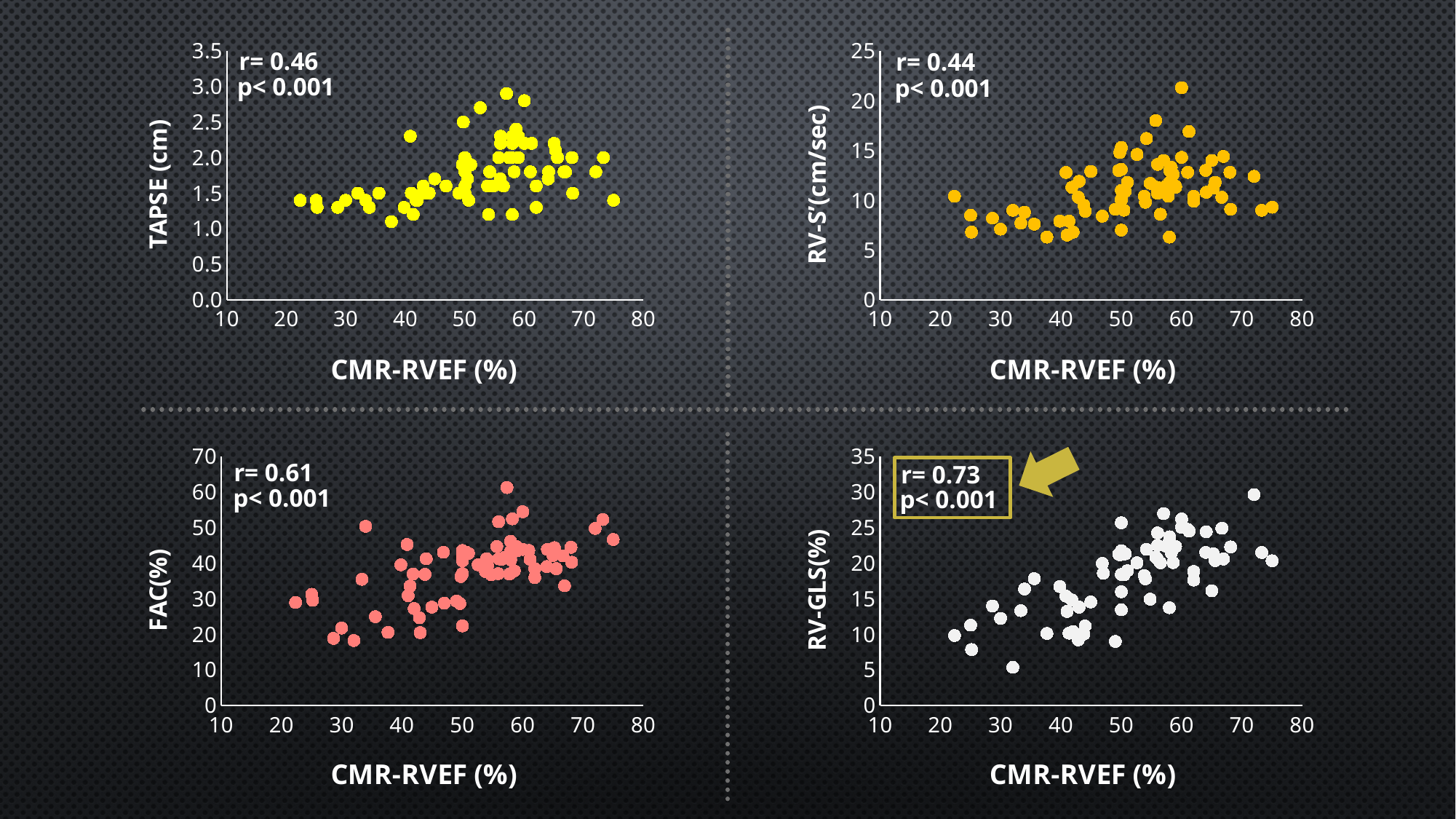
What p value is shown on the bottom-right chart (RV-GLS vs CMR-RVEF)? p< 0.001 What is the difference between the r value of the RV-GLS chart and the r value of the FAC chart? 0.12 Which of the four charts shows the highest correlation coefficient r? RV-GLS vs CMR-RVEF (r= 0.73) In the top-left chart (TAPSE vs CMR-RVEF), is the highest TAPSE value greater or less than 2.5? greater What is the x-axis label shared by all four charts? CMR-RVEF (%) How many scatter charts are shown on the slide? 4 What is the correlation coefficient r shown on the top-left chart (TAPSE vs CMR-RVEF)? r= 0.46 In the bottom-right chart (RV-GLS vs CMR-RVEF), do the RV-GLS values generally rise or fall as CMR-RVEF increases? rise What is the correlation coefficient r shown on the bottom-left chart (FAC vs CMR-RVEF)? r= 0.61 What kind of chart is the top-left chart (TAPSE vs CMR-RVEF)? scatter chart Which chart has the larger r value: the TAPSE chart or the RV-S' chart? TAPSE chart What is the correlation coefficient r shown on the top-right chart (RV-S' vs CMR-RVEF)? r= 0.44